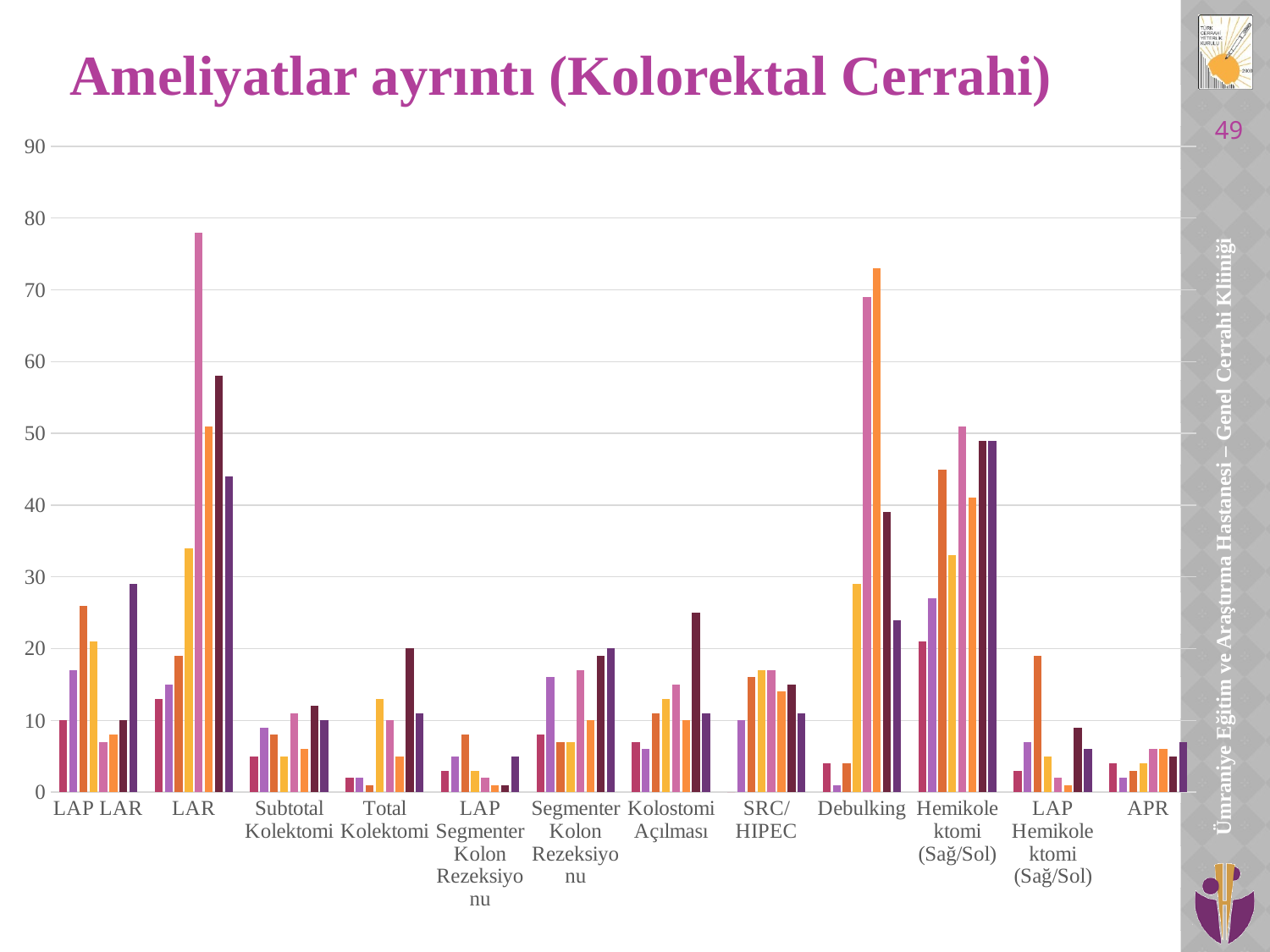
What is the title of the chart? Ameliyatlar ayrıntı (Kolorektal Cerrahi) What is the highest value shown on the y axis of the chart? 90 Is the tallest bar for Hemikolektomi (Sağ/Sol) greater or less than 40? greater Which category contains the tallest bar in the chart? LAR How many categories are shown along the x axis of the chart? 12 Is the tallest bar for Debulking greater or less than 60? greater Is the tallest bar for Subtotal Kolektomi greater or less than 20? less What kind of chart is shown on the slide? bar chart